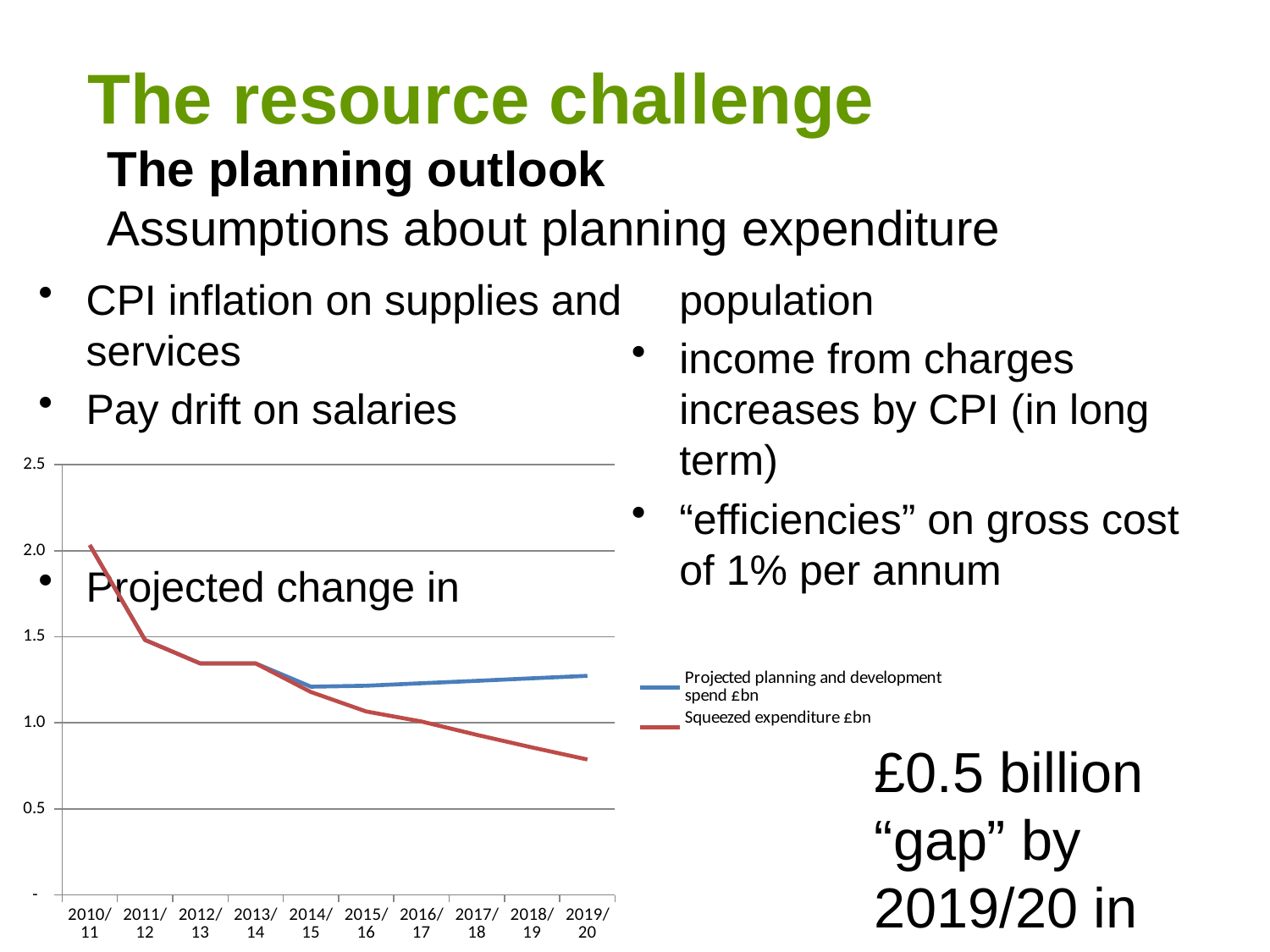
What kind of chart is shown on the slide? Line chart What colour is the line for Squeezed expenditure £bn? Red Which year is the first on the chart's x axis? 2010/11 How many series does the chart's legend list? 2 In which year is Squeezed expenditure £bn at its lowest? 2019/20 Does the Squeezed expenditure £bn line rise or fall from 2010/11 to 2019/20? Fall Is the value for Squeezed expenditure £bn in 2010/11 greater or less than 1.5? greater Is the value for Squeezed expenditure £bn in 2019/20 greater or less than 1.0? less In which year is Squeezed expenditure £bn at its highest? 2010/11 How many years are shown along the x axis of the chart? 10 Is the value for Projected planning and development spend £bn in 2019/20 greater or less than 1.0? greater In 2019/20, which series is higher: Projected planning and development spend £bn or Squeezed expenditure £bn? Projected planning and development spend £bn